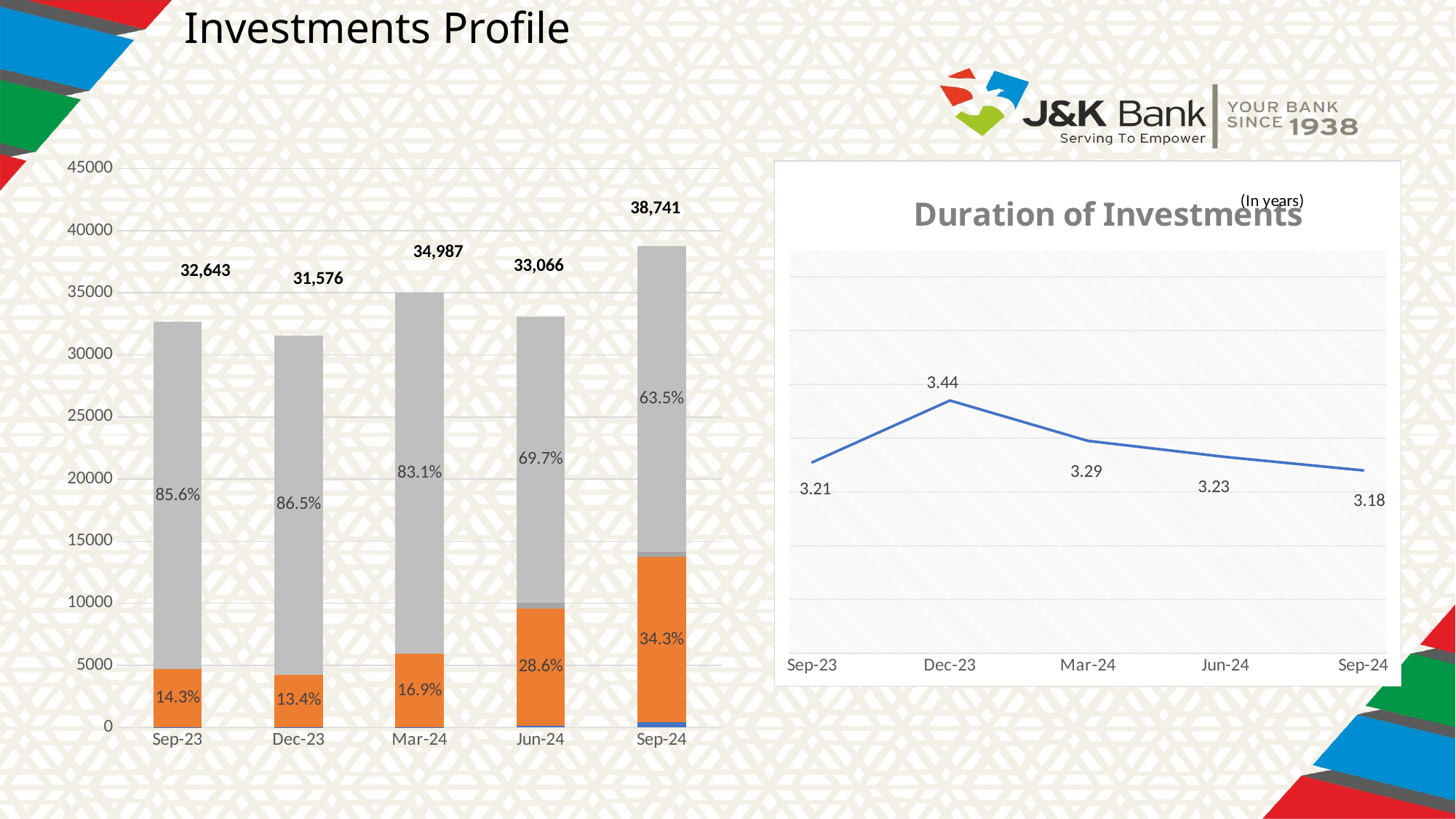
In the stacked bar chart on the left, how many periods are shown on the x axis? 5 In the Duration of Investments chart, what is the difference between the Dec-23 value and the Sep-24 value? 0.26 In the Duration of Investments chart, which period has the lowest value? Sep-24 In the Duration of Investments chart, what is the value for Dec-23? 3.44 In the stacked bar chart on the left, what is the total value shown above the Sep-24 bar? 38,741 In the stacked bar chart on the left, what percentage is labelled on the orange segment of the Jun-24 bar? 28.6% What kind of chart is the Duration of Investments chart? Line chart In the stacked bar chart on the left, which period has the highest total? Sep-24 In the stacked bar chart on the left, is the Mar-24 total greater or less than 35000? less In the stacked bar chart on the left, which period has the lowest total? Dec-23 In the stacked bar chart on the left, what percentage is labelled on the grey segment of the Dec-23 bar? 86.5% In the stacked bar chart on the left, what is the difference between the Sep-24 total and the Sep-23 total? 6,098